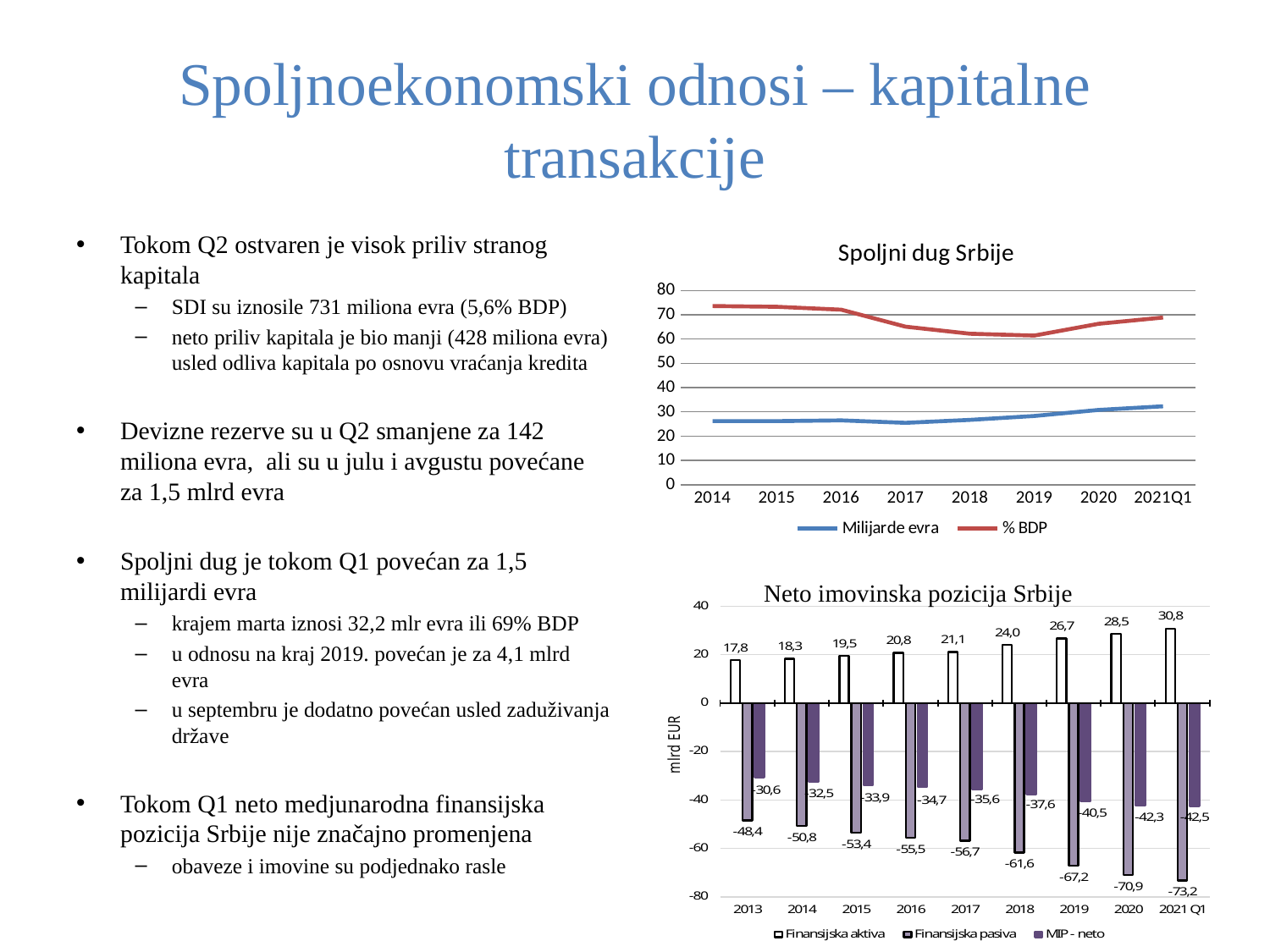
In the 'Spoljni dug Srbije' chart, is the Milijarde evra value for 2014 greater or less than 30? less In the 'Neto imovinska pozicija Srbije' chart, how many years are shown on the x axis? 9 In the 'Neto imovinska pozicija Srbije' chart, which year has the lowest Finansijska pasiva value? 2021 Q1 In the 'Spoljni dug Srbije' chart, does the Milijarde evra series rise or fall between 2017 and 2021Q1? Rise What kind of chart is 'Spoljni dug Srbije'? Line chart In the 'Neto imovinska pozicija Srbije' chart, how many series does the legend list? 3 In the 'Neto imovinska pozicija Srbije' chart, what is the MIP - neto value for 2013? -30,6 In the 'Neto imovinska pozicija Srbije' chart, what is the value of Finansijska pasiva for 2018? -61,6 In the 'Neto imovinska pozicija Srbije' chart, which year has the highest Finansijska aktiva value? 2021 Q1 In the 'Neto imovinska pozicija Srbije' chart, what is the difference between Finansijska aktiva in 2020 and in 2013? 10,7 In the 'Neto imovinska pozicija Srbije' chart, what is the value of Finansijska aktiva for 2021 Q1? 30,8 In the 'Spoljni dug Srbije' chart, is the % BDP value for 2014 greater or less than 70? greater